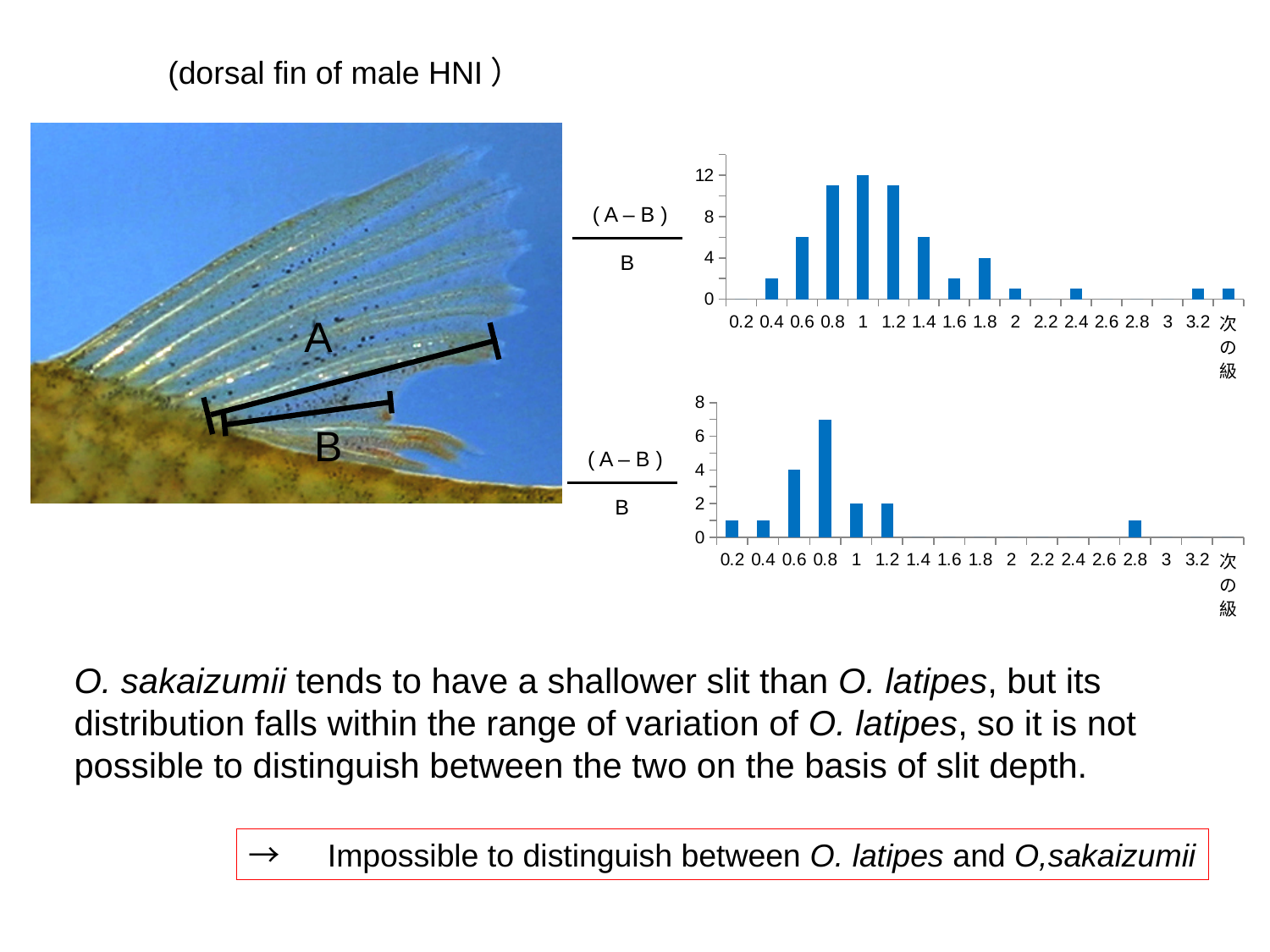
In the bottom chart, what is the value of the bar at 0.6? 4 In the top chart, which bar is taller, the one at 0.6 or the one at 1.6? 0.6 How many bars are plotted in the bottom chart? 7 In the top chart, what is the value of the bar at 1? 12 In the bottom chart, which x-axis category has the tallest bar? 0.8 In the top chart, what is the value of the bar at 1.8? 4 What is the highest value shown on the y-axis of the top chart? 12 In the top chart, is the value for 0.8 greater or less than 8? greater In the bottom chart, what is the value of the bar at 1.2? 2 What kind of chart is the top chart on the slide? bar chart In the bottom chart, is the value for 0.8 greater or less than 6? greater In the top chart, which x-axis category has the tallest bar? 1